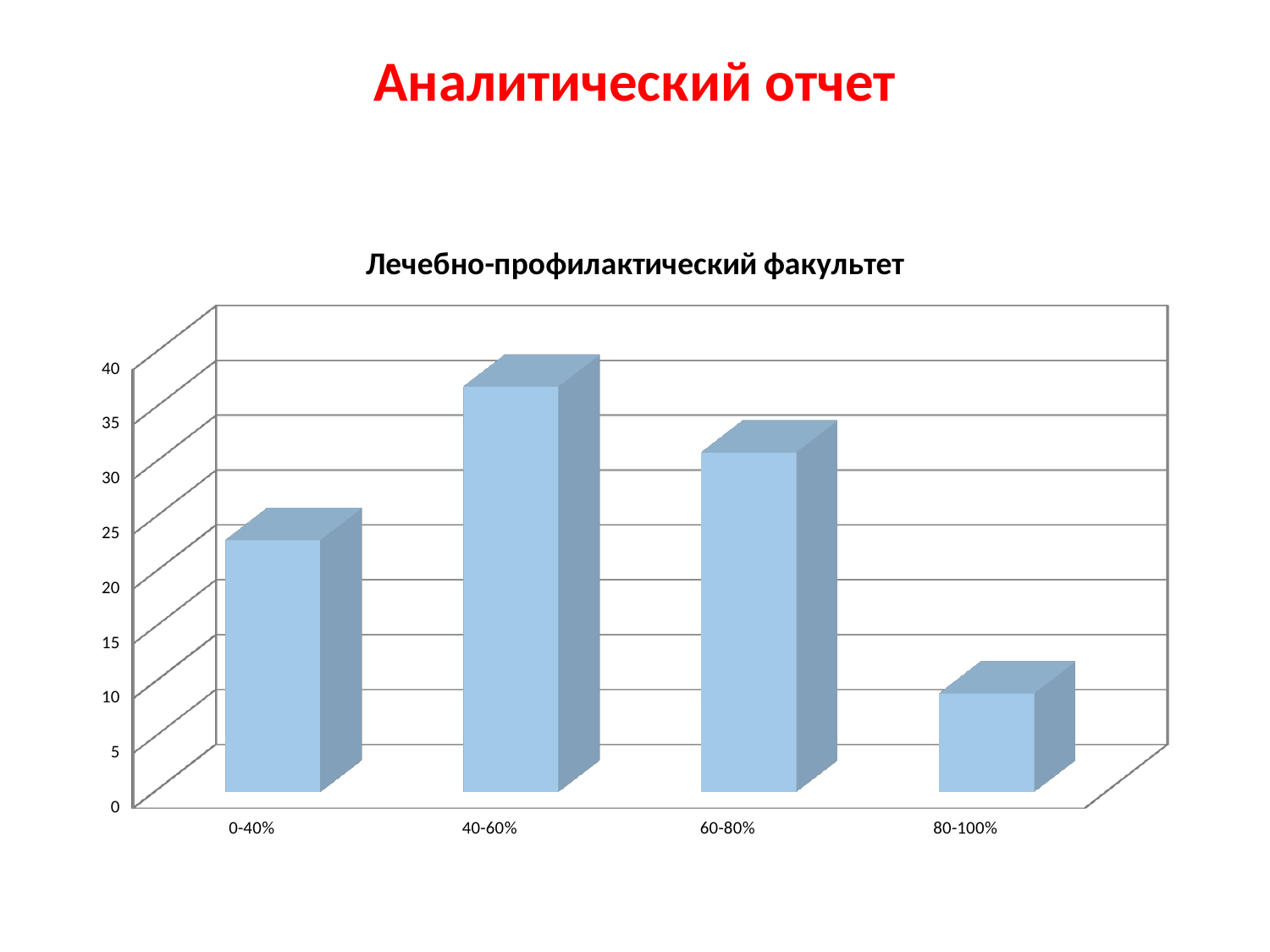
Which category has the lowest bar? 80-100% Does the value rise or fall from 60-80% to 80-100%? fall Is the value for 40-60% greater or less than 35? greater How many categories are shown on the x axis of the chart? 4 Which is larger, the value for 40-60% or the value for 60-80%? 40-60% Which category has the highest bar? 40-60% Is the value for 60-80% greater or less than 25? greater Is the value for 80-100% greater or less than 15? less Which is larger, the value for 0-40% or the value for 60-80%? 60-80% What is the title of the chart? Лечебно-профилактический факультет What kind of chart is shown on the slide? bar chart